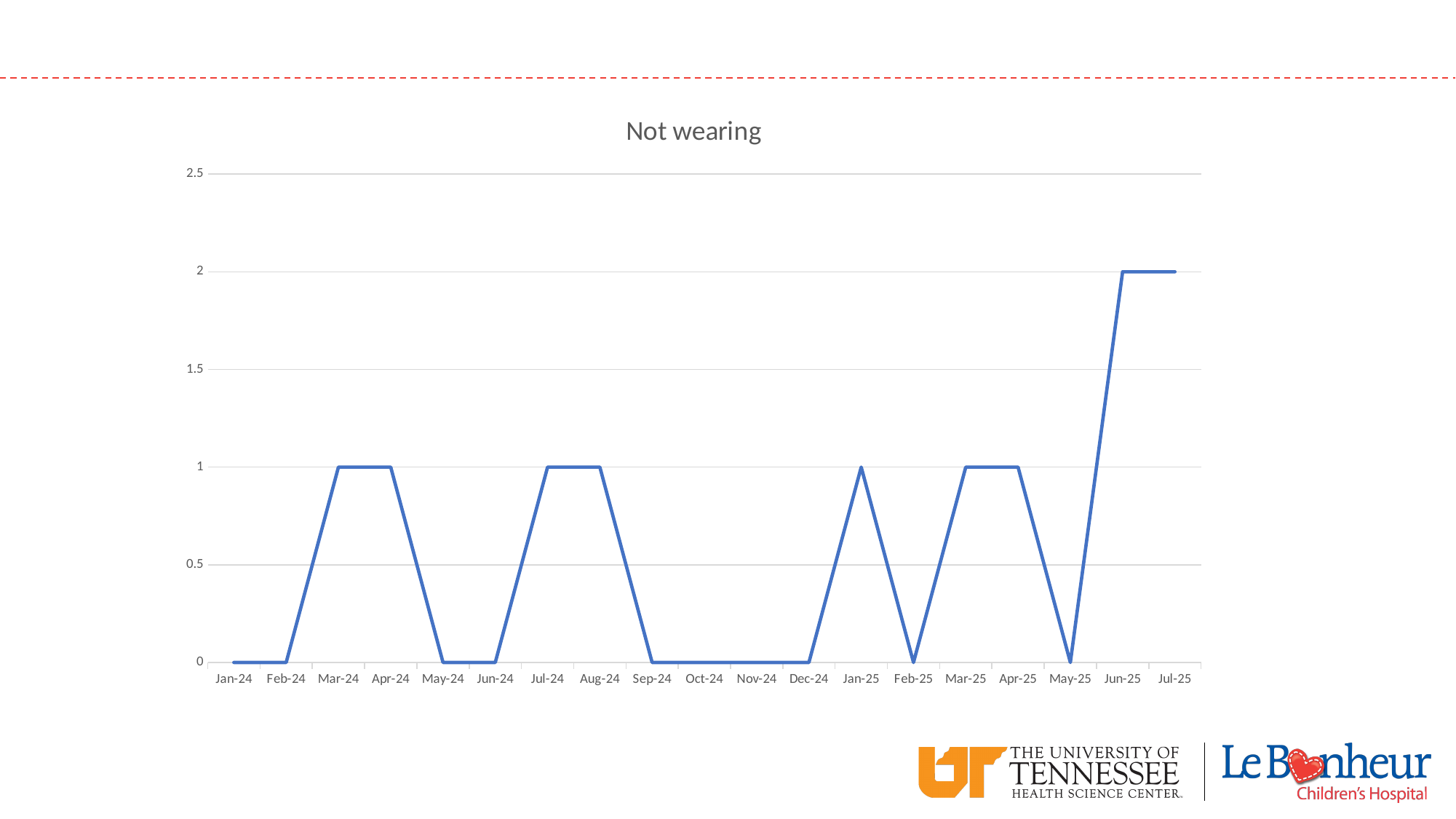
How many months are plotted along the x axis? 19 What is the value for Mar-24? 1 What is the title of the chart? Not wearing What is the difference between the values for Jul-25 and Apr-25? 1 What is the value for Jan-25? 1 Does the line rise or fall between May-25 and Jun-25? rise What is the value for Jun-25? 2 Is the value for Jun-25 greater or less than 1.5? greater What is the value for Oct-24? 0 Which is larger, the value for Aug-24 or the value for Sep-24? Aug-24 What kind of chart is shown on the slide? line chart Which month has the highest value? Jun-25 and Jul-25